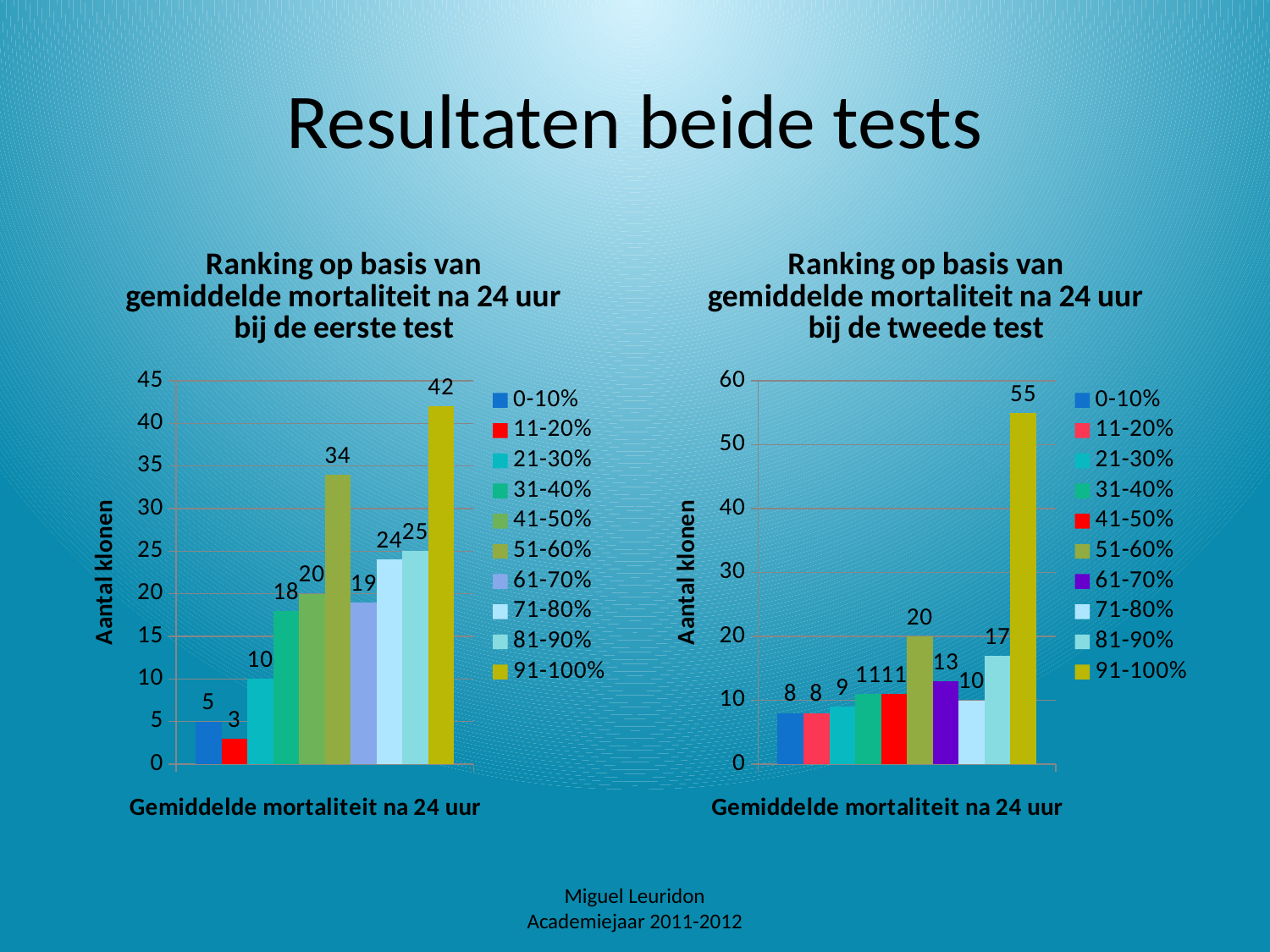
What is the y-axis label of the right chart (second test)? Aantal klonen What type of chart is the left chart (first test)? bar chart In the right chart (second test), what is the value for the 51-60% category? 20 In the right chart (second test), which category has the highest value? 91-100% In the left chart (first test), which is larger: the value for 61-70% or the value for 71-80%? 71-80% In the left chart (first test), what is the difference between the 91-100% value and the 51-60% value? 8 In the right chart (second test), is the value for 91-100% greater or less than 50? greater In the right chart (second test), what is the difference between the 91-100% value and the 81-90% value? 38 In the left chart (first test), what is the value for the 91-100% category? 42 How many legend entries does the right chart (second test) list? 10 In the left chart (first test), which category has the lowest value? 11-20% In the left chart (first test), what is the value for the 11-20% category? 3